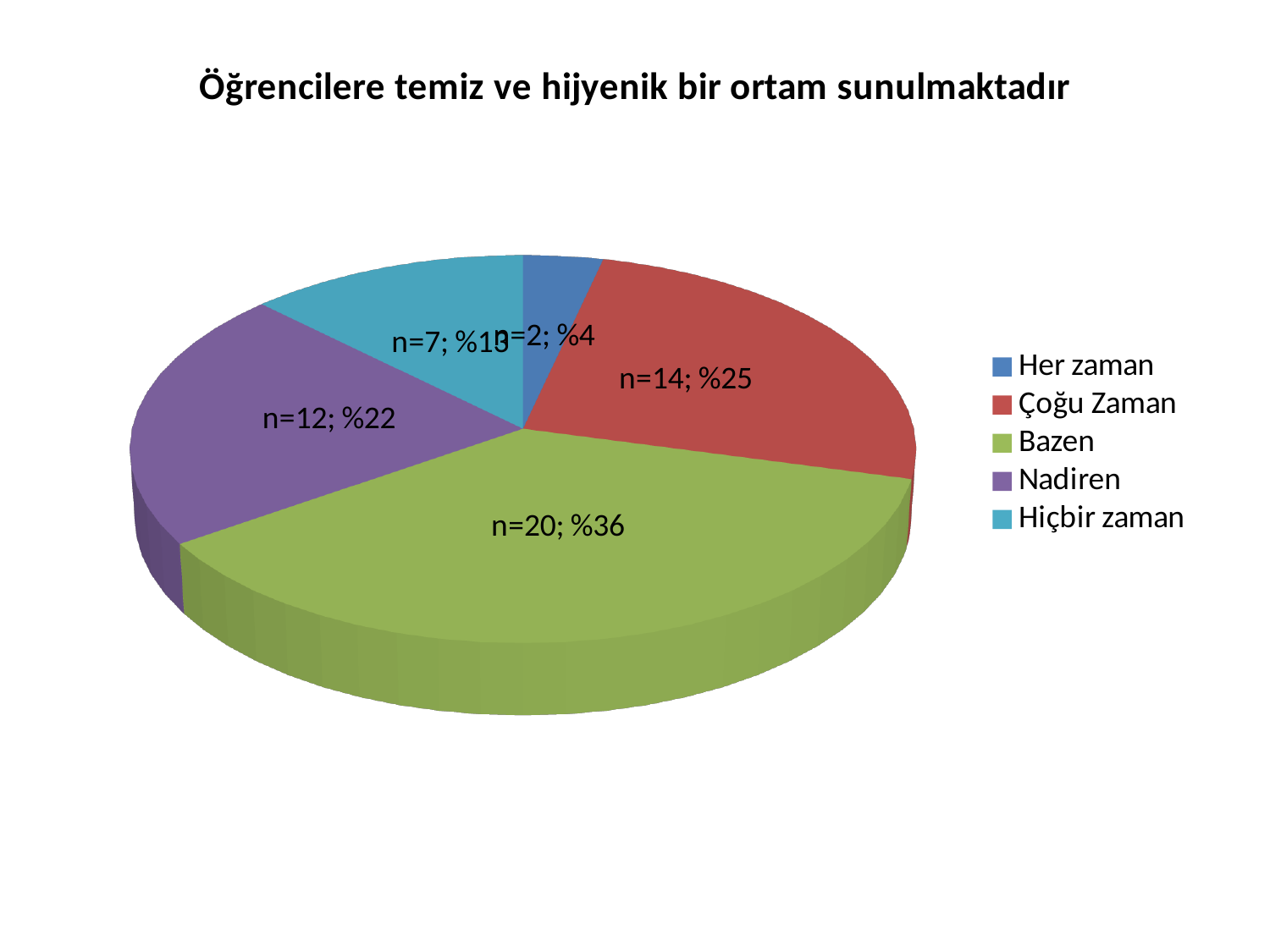
What is the count (n) for the Bazen slice? n=20 Which category has the largest slice of the pie? Bazen Which category has the smallest slice of the pie? Her zaman Which has a larger count, Çoğu Zaman or Nadiren? Çoğu Zaman What percentage share does the Bazen slice have? %36 What kind of chart is shown on the slide? pie chart What is the count (n) for the Çoğu Zaman slice? n=14 What percentage share does the Her zaman slice have? %4 How many categories does the pie chart have? 5 What percentage share does the Nadiren slice have? %22 What is the title of the chart? Öğrencilere temiz ve hijyenik bir ortam sunulmaktadır What is the difference in count (n) between Bazen and Hiçbir zaman? 13